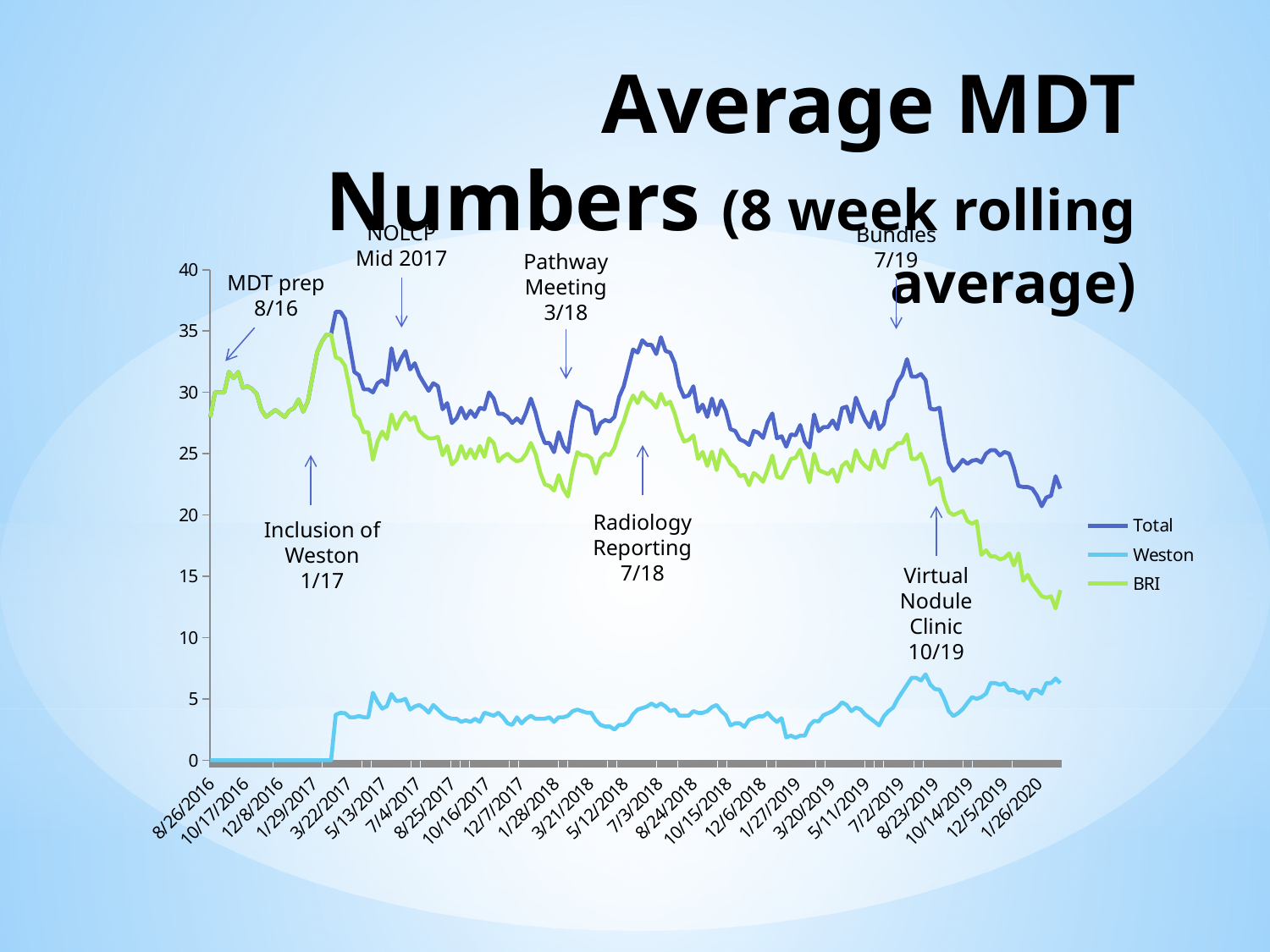
Is the BRI value at 1/26/2020 greater or less than 20? less Does the BRI series rise or fall between 7/2/2019 and 1/26/2020? fall Which series has the lowest values across the whole chart? Weston What event is annotated on the chart at 1/17? Inclusion of Weston What is the Weston value at 8/26/2016? 0 Is the Total value at 1/26/2020 greater or less than 25? less At 7/3/2018, which is larger, the Total value or the BRI value? Total Which series has the highest values across the whole chart? Total What type of chart is shown on the slide? line chart How many series does the legend list? 3 Is the Weston value at 1/26/2020 greater or less than 10? less